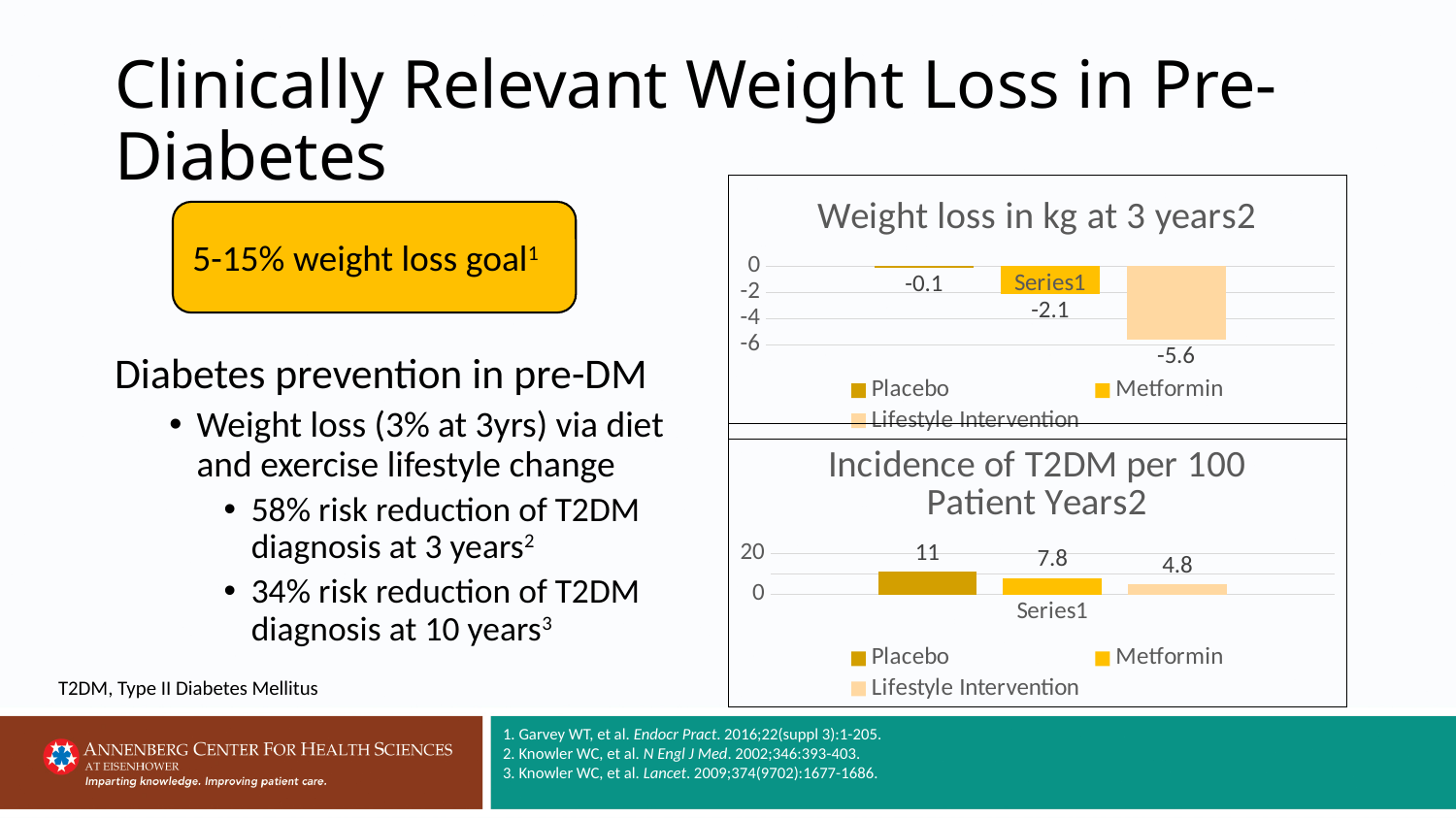
In the 'Weight loss in kg at 3 years' chart, what is the difference between the Lifestyle Intervention and Metformin values? 3.5 In the 'Incidence of T2DM per 100 Patient Years' chart, what is the value for Lifestyle Intervention? 4.8 How many series does the legend of the 'Incidence of T2DM per 100 Patient Years' chart list? 3 In the 'Weight loss in kg at 3 years' chart, which series shows the greatest weight loss (lowest value)? Lifestyle Intervention What kind of chart is the 'Weight loss in kg at 3 years' chart? Bar chart In the 'Weight loss in kg at 3 years' chart, what is the value for Metformin? -2.1 In the 'Weight loss in kg at 3 years' chart, what is the value for Placebo? -0.1 In the 'Incidence of T2DM per 100 Patient Years' chart, what is the value for Placebo? 11 In the 'Incidence of T2DM per 100 Patient Years' chart, which is larger, the value for Metformin or the value for Lifestyle Intervention? Metformin In the 'Incidence of T2DM per 100 Patient Years' chart, which series has the highest value? Placebo In the 'Incidence of T2DM per 100 Patient Years' chart, what is the difference between the Placebo and Metformin values? 3.2 In the 'Weight loss in kg at 3 years' chart, what is the value for Lifestyle Intervention? -5.6